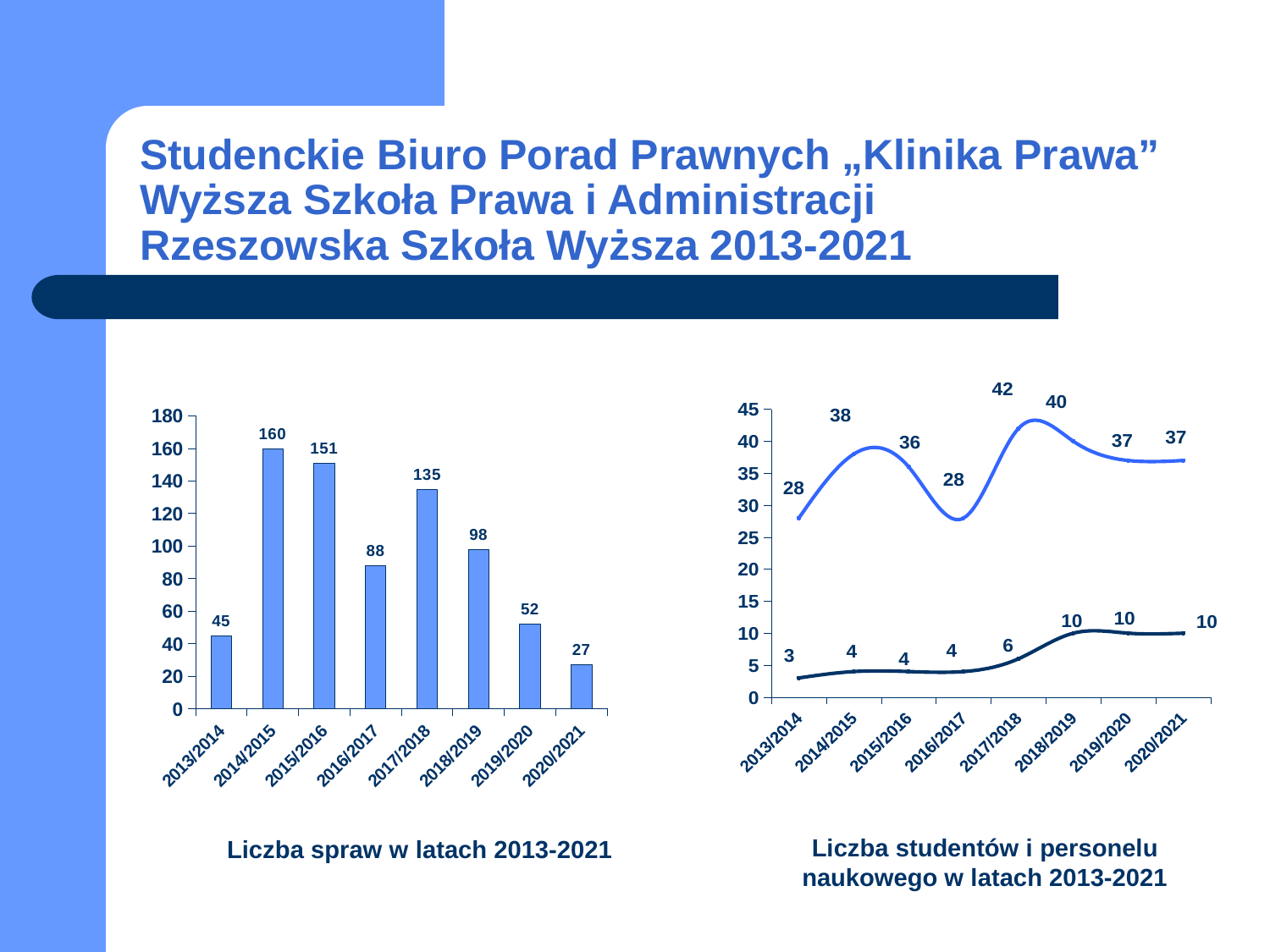
In the left chart (Liczba spraw w latach 2013-2021), which is larger, the value for 2016/2017 or the value for 2018/2019? 2018/2019 What kind of chart is the right chart (Liczba studentów i personelu naukowego w latach 2013-2021)? line chart In the right chart (Liczba studentów i personelu naukowego w latach 2013-2021), what is the value of the upper line for 2017/2018? 42 In the left chart (Liczba spraw w latach 2013-2021), which year has the lowest value? 2020/2021 In the left chart (Liczba spraw w latach 2013-2021), what is the value for 2014/2015? 160 In the right chart (Liczba studentów i personelu naukowego w latach 2013-2021), what is the value of the lower line for 2013/2014? 3 In the left chart (Liczba spraw w latach 2013-2021), which year has the highest value? 2014/2015 In the left chart (Liczba spraw w latach 2013-2021), what is the value for 2017/2018? 135 In the right chart (Liczba studentów i personelu naukowego w latach 2013-2021), what is the difference between the upper line and the lower line for 2020/2021? 27 How many years are shown on the x axis of the left chart (Liczba spraw w latach 2013-2021)? 8 What kind of chart is the left chart (Liczba spraw w latach 2013-2021)? bar chart In the left chart (Liczba spraw w latach 2013-2021), what is the difference between the values for 2014/2015 and 2015/2016? 9